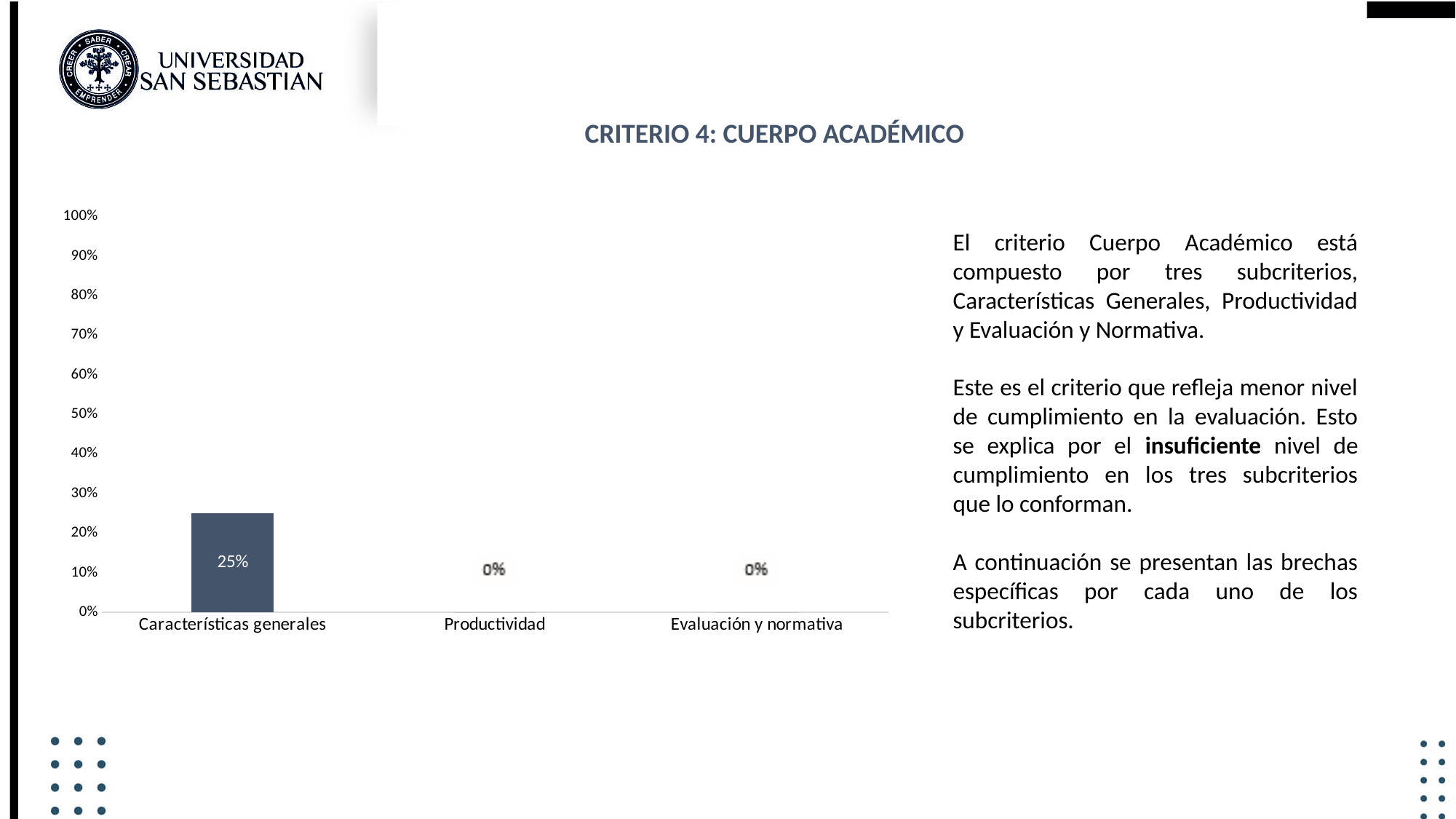
Is the value for Características generales greater or less than 30%? less What is the difference between the values for Características generales and Productividad? 25% What is the maximum value shown on the y axis? 100% What is the value for Características generales? 25% What is the value for Productividad? 0% What is the value for Evaluación y normativa? 0% Which category has the highest value? Características generales Is the value for Características generales greater or less than 20%? greater How many categories are shown on the x axis? 3 What kind of chart is shown on the slide? bar chart Which is larger, the value for Características generales or the value for Evaluación y normativa? Características generales What is the title shown above the chart? CRITERIO 4: CUERPO ACADÉMICO